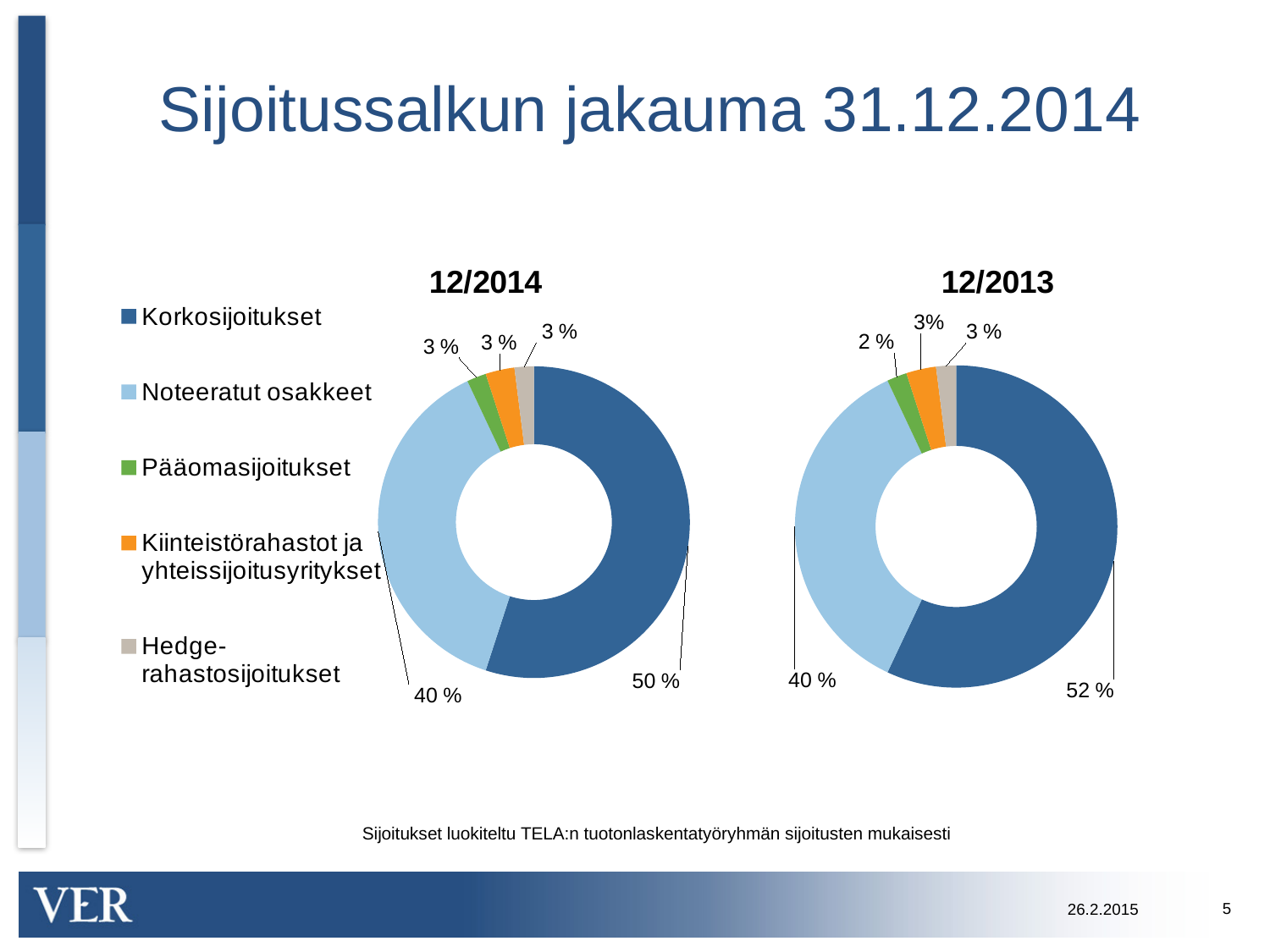
In the 12/2013 chart, which category has the smallest share? Pääomasijoitukset Is the Korkosijoitukset share larger in the 12/2014 chart or in the 12/2013 chart? 12/2013 In the 12/2014 chart, what share is Noteeratut osakkeet? 40 % In the 12/2013 chart, what share is Korkosijoitukset? 52 % What is the difference between the Korkosijoitukset share in the 12/2013 chart and in the 12/2014 chart? 2 % In the 12/2014 chart, what is the difference between the Korkosijoitukset share and the Noteeratut osakkeet share? 10 % Which colour represents Kiinteistörahastot ja yhteissijoitusyritykset in the charts? Orange In the 12/2013 chart, what share is Pääomasijoitukset? 2 % In the 12/2014 chart, which category has the largest share? Korkosijoitukset In the 12/2014 chart, what share is Korkosijoitukset? 50 % How many categories does the legend list for the charts? 5 What kind of chart is the 12/2014 chart? Doughnut (pie) chart